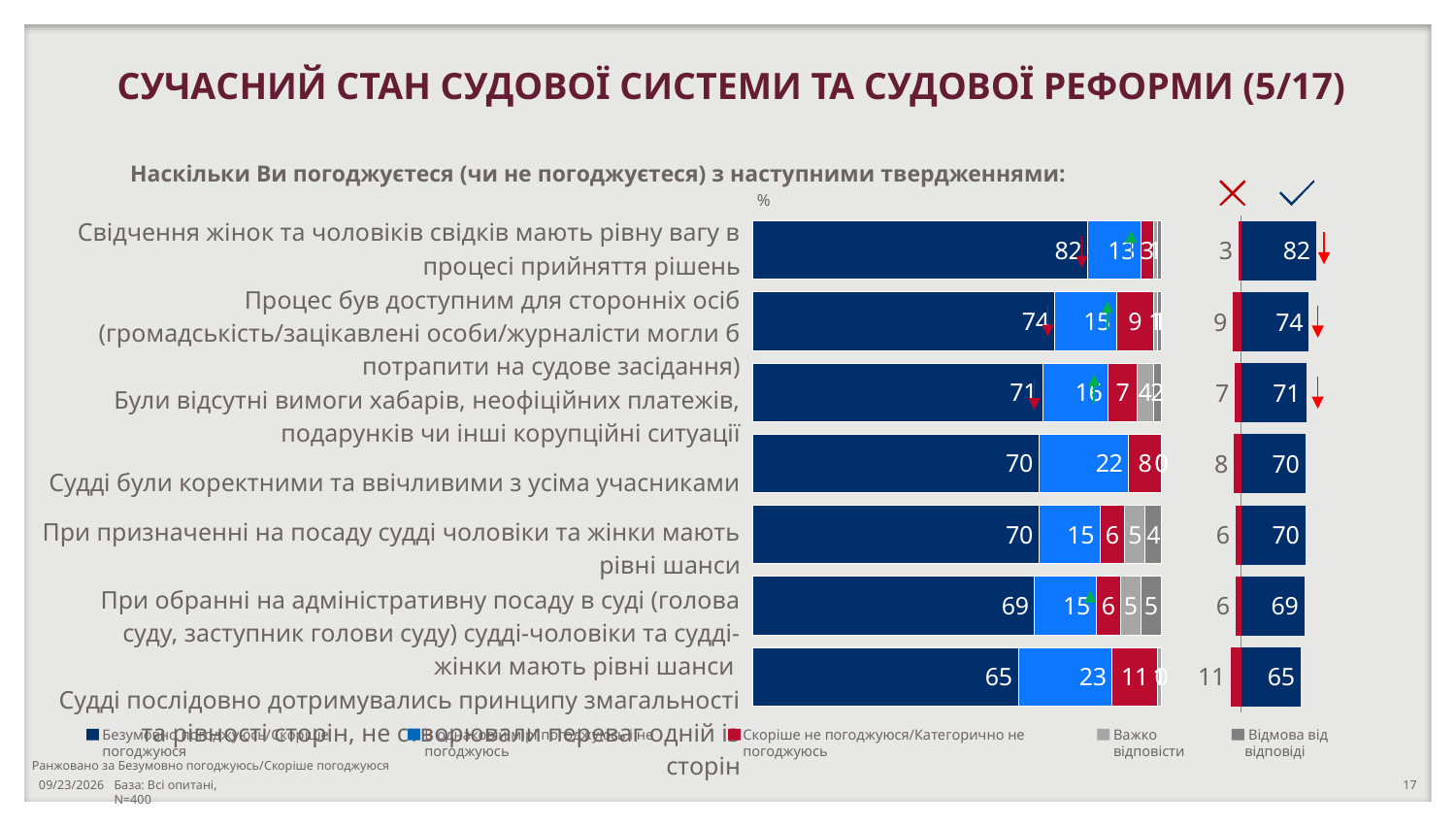
How many series does the legend list? 5 What type of chart is shown on the slide? stacked bar chart Which statement has the lowest value in the dark blue (agree) segment? Судді послідовно дотримувались принципу змагальності та рівності сторін What is the value of the light blue segment for the statement "Були відсутні вимоги хабарів, неофіційних платежів..."? 16 Which statement has the highest value in the dark blue (agree) segment? Свідчення жінок та чоловіків свідків мають рівну вагу в процесі прийняття рішень What is the value of the light blue segment for the statement "Судді були коректними та ввічливими з усіма учасниками"? 22 What is the value of the dark blue (agree) segment for the statement "Свідчення жінок та чоловіків свідків мають рівну вагу в процесі прийняття рішень"? 82 How many statements (bars) are shown in the chart? 7 What is the value of the dark blue (agree) segment for the statement "Судді послідовно дотримувались принципу змагальності та рівності сторін..."? 65 Which has a larger red (disagree) value: "Судді послідовно дотримувались принципу змагальності..." or "Судді були коректними та ввічливими з усіма учасниками"? Судді послідовно дотримувались принципу змагальності та рівності сторін What is the value of the red (disagree) segment for the statement "Процес був доступним для сторонніх осіб..."? 9 What is the difference between the dark blue (agree) values for "Свідчення жінок та чоловіків свідків мають рівну вагу..." and "Судді послідовно дотримувались принципу змагальності..."? 17